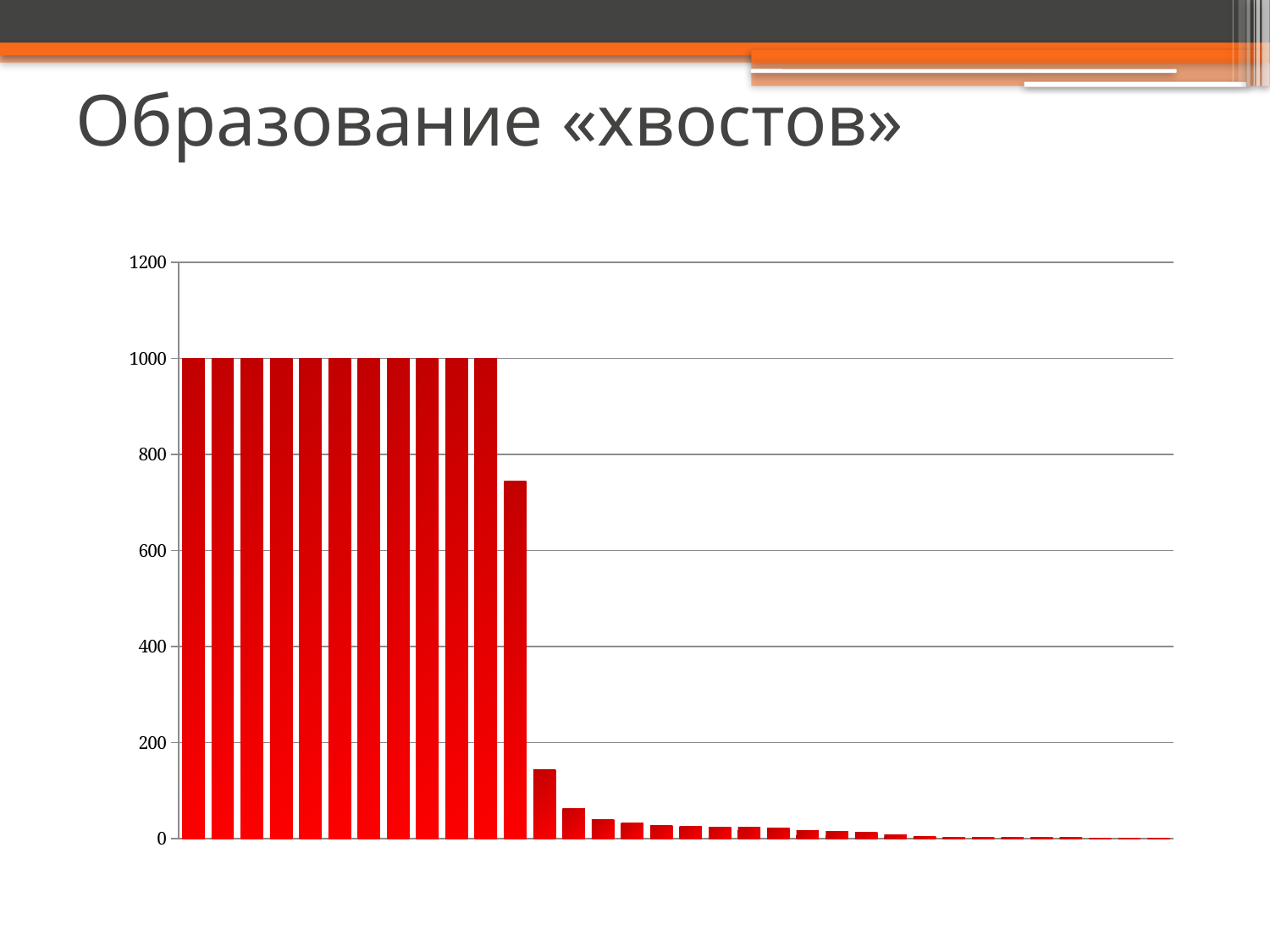
What is the title of the slide containing the chart? Образование «хвостов» Is the value of the rightmost bar greater or less than 200? less What kind of chart is shown on the slide? bar chart What value does the first (leftmost) bar reach on the y axis? 1000 Is the value of the 12th bar from the left greater or less than 600? greater How many bars reach the 1000 level on the y axis? 11 Is the value of the 12th bar from the left greater or less than 800? less What is the highest tick value shown on the y axis? 1200 What is the highest value reached by any bar in the chart? 1000 Which is larger: the first bar from the left or the 12th bar from the left? the first bar Do the bar values rise or fall moving from left to right along the x axis? fall